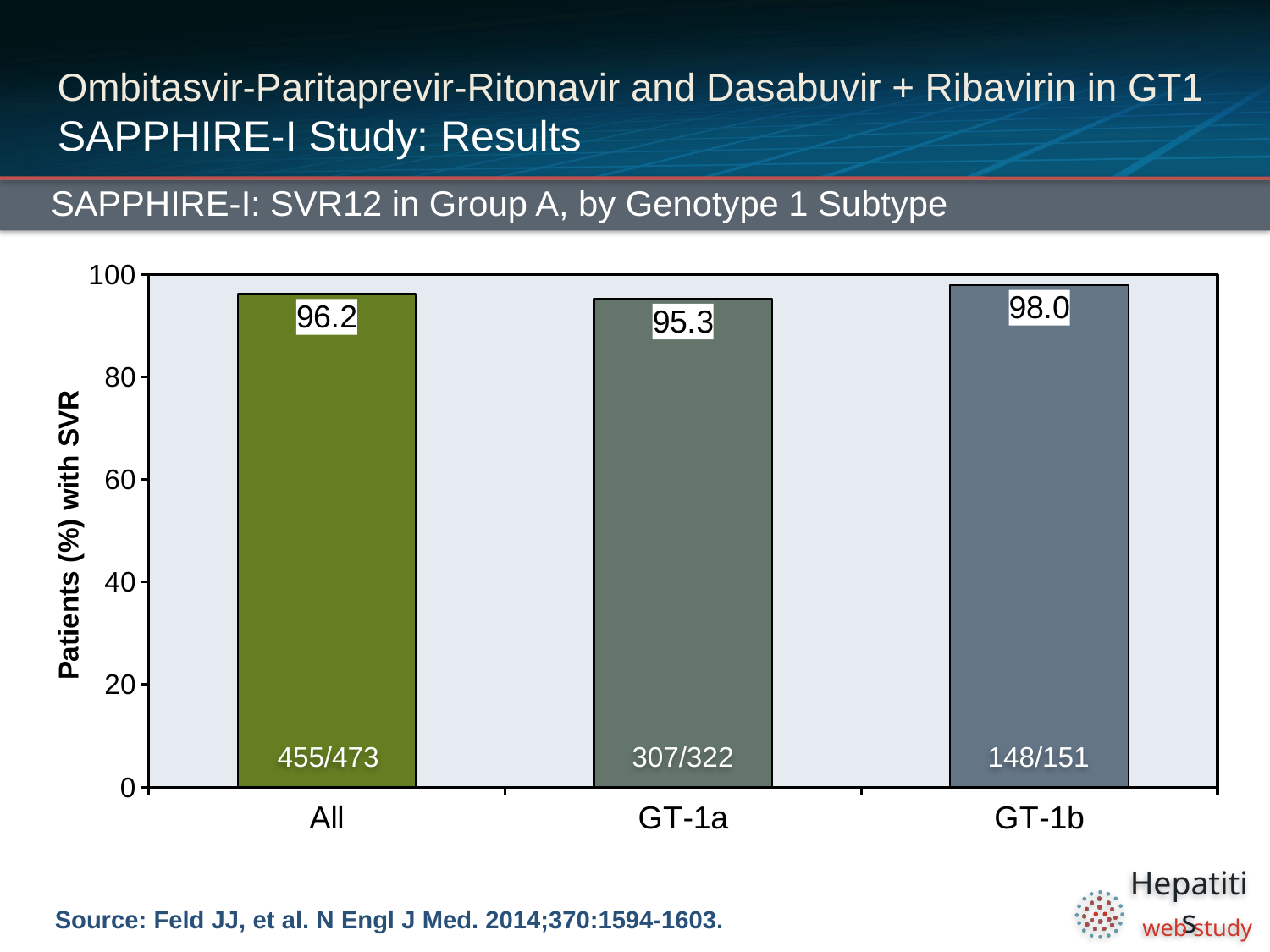
Which group has the lowest SVR12 rate? GT-1a What is the SVR12 rate shown for GT-1a? 95.3 Which has a higher SVR12 rate, All or GT-1a? All What type of chart is shown on the slide? Bar chart What is the SVR12 rate shown for GT-1b? 98.0 What is the difference in SVR12 rate between GT-1b and GT-1a? 2.7 What is the label of the y axis? Patients (%) with SVR What patient fraction is printed on the GT-1b bar? 148/151 What is the SVR12 rate shown for the All group? 96.2 What patient fraction is printed on the GT-1a bar? 307/322 How many groups are shown on the x axis? 3 Which subtype group has the highest SVR12 rate? GT-1b